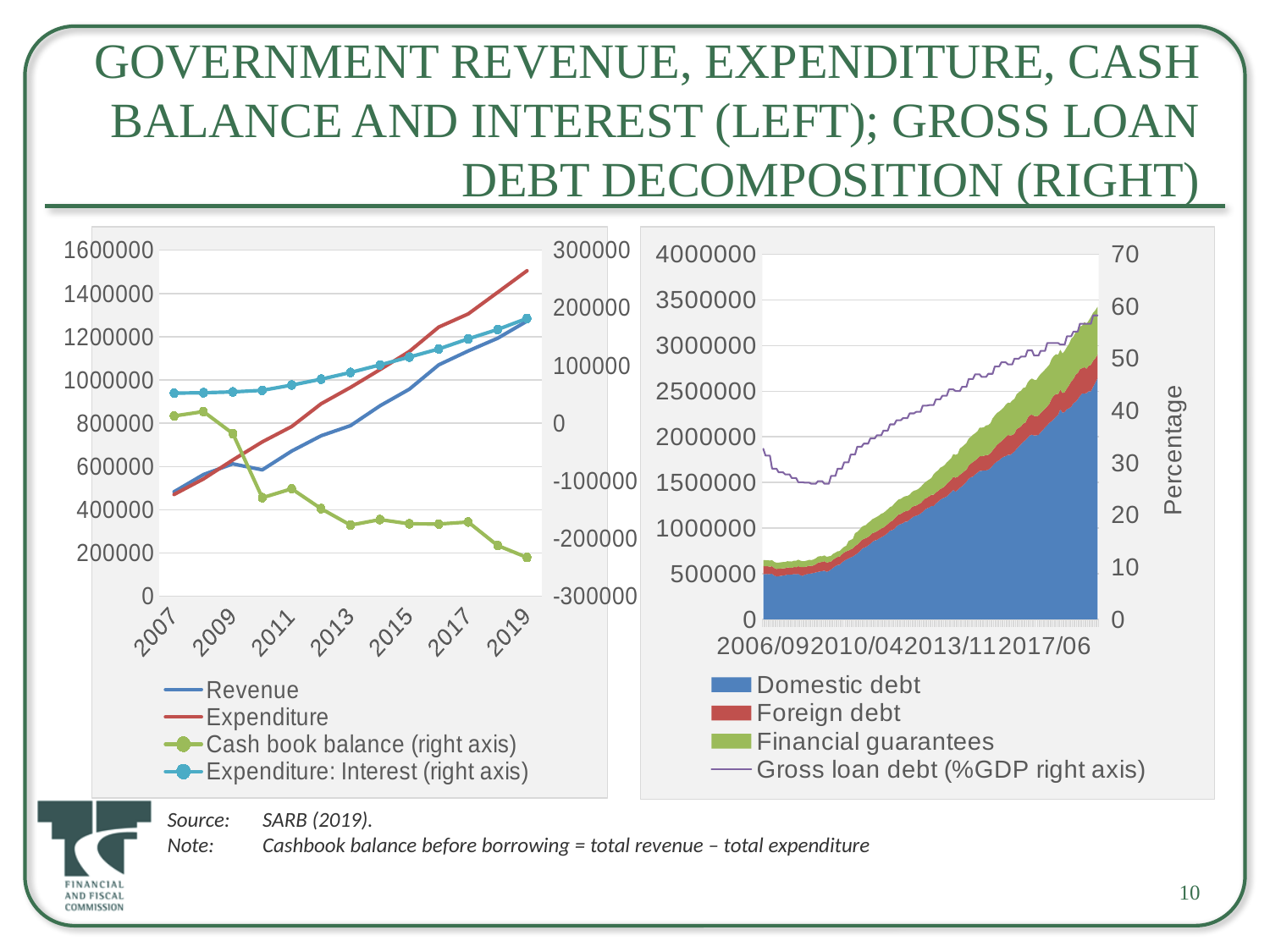
On the left chart, does the Cash book balance (right axis) series rise or fall from 2007 to 2019? Fall What kind of chart is the left chart? Line chart On the right chart, how many series does the legend list? 4 On the right chart, does Domestic debt rise or fall over the period shown? Rise On the left chart, which is larger in 2019, Revenue or Expenditure? Expenditure On the right chart, which series is plotted against the right axis labelled Percentage? Gross loan debt (%GDP right axis) On the left chart, does the Expenditure: Interest (right axis) series rise or fall from 2007 to 2019? Rise On the left chart, how many series does the legend list? 4 On the right chart, which series forms the bottom (largest) layer of the stacked area? Domestic debt On the left chart, is the value for Revenue in 2007 greater or less than 600000? less On the right chart, is the final value of Gross loan debt (%GDP right axis) greater or less than 50? greater On the left chart, is the value for Expenditure in 2019 greater or less than 1400000? greater